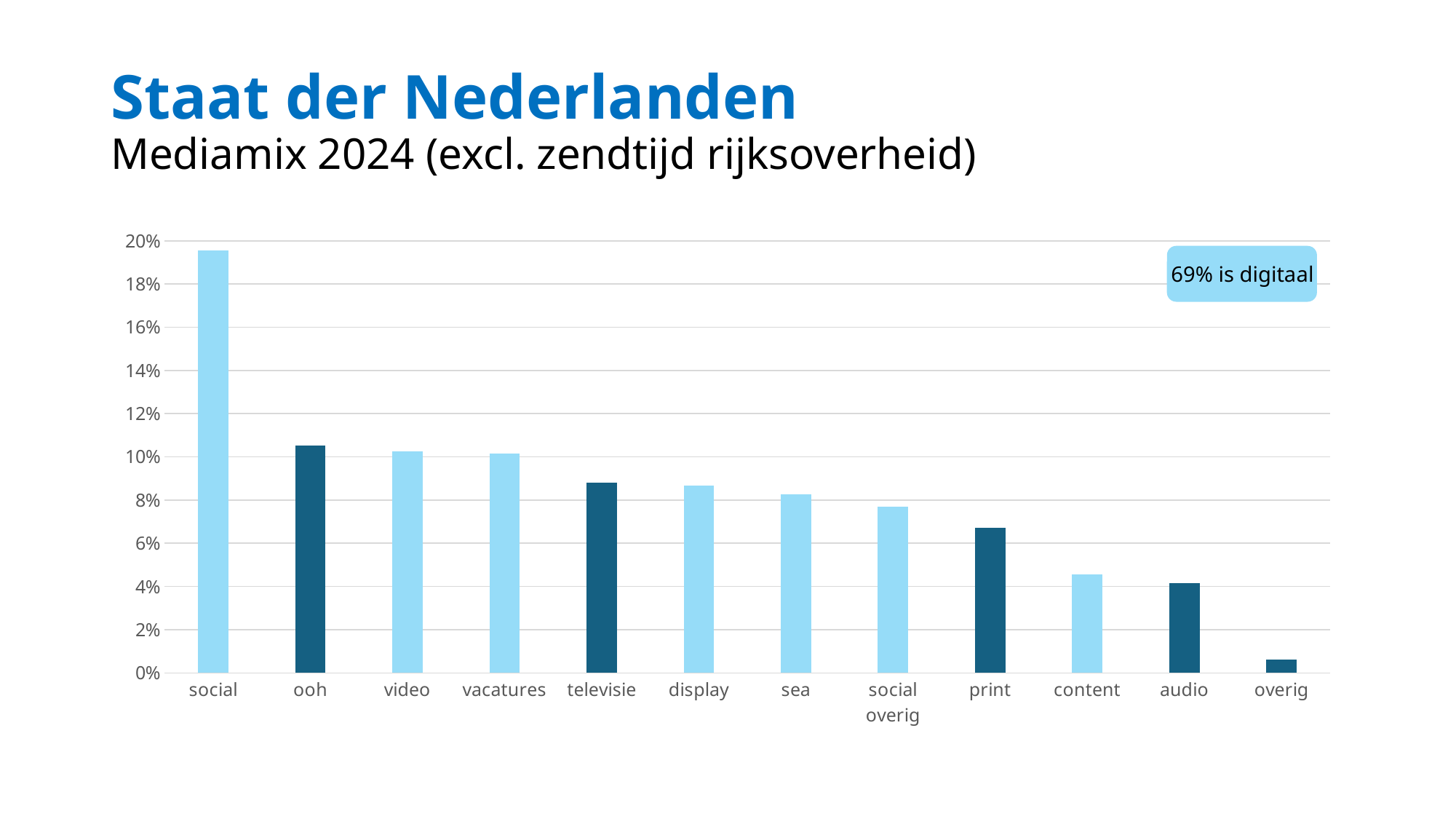
Is the value for social greater or less than 18%? greater Is the value for print greater or less than 6%? greater Which category has the lowest value in the chart? overig What kind of chart is shown on the slide? bar chart Which is larger, the value for print or the value for content? print Is the value for televisie greater or less than 8%? greater How many categories are shown on the x axis of the chart? 12 Which category has the highest value in the chart? social Do the values rise or fall from left to right along the x axis? fall What does the callout box in the top right of the chart say? 69% is digitaal